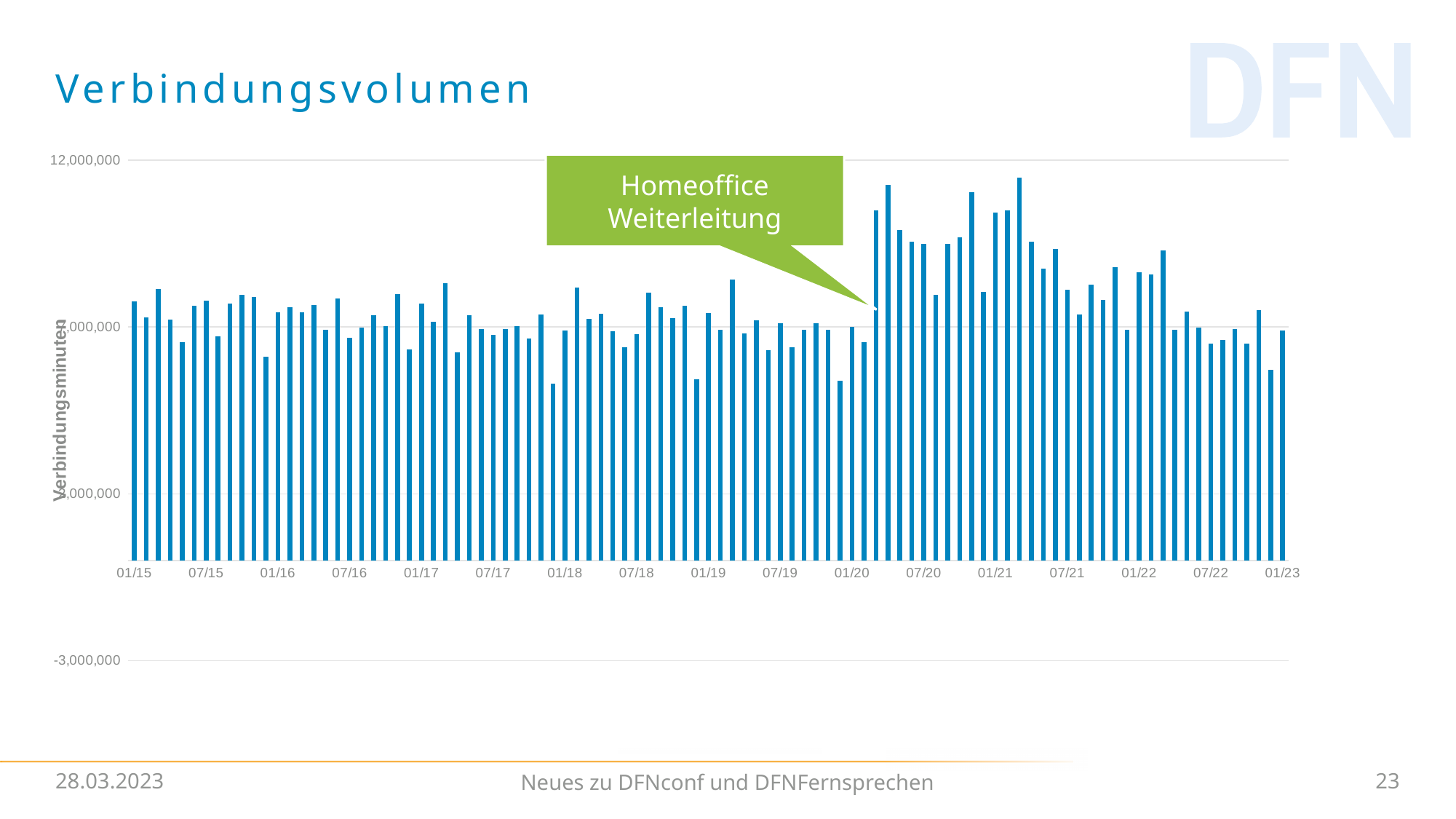
Is the value for 01/15 greater or less than -3,000,000? greater How many date labels are shown on the x axis? 17 Which is larger, the value for 01/15 or the value for 01/23? 01/15 Which is larger, the value for 01/21 or the value for 01/15? 01/21 What kind of chart is shown on the slide? bar chart What is the title of the slide above the chart? Verbindungsvolumen Do the values generally rise or fall between 01/21 and 01/23? fall What is the first date label on the x axis? 01/15 Is the value for 01/21 greater or less than 12,000,000? less What text does the green callout on the chart contain? Homeoffice Weiterleitung Which is larger, the value for 07/20 or the value for 07/15? 07/20 Do the values rise or fall between 01/20 and 07/20? rise